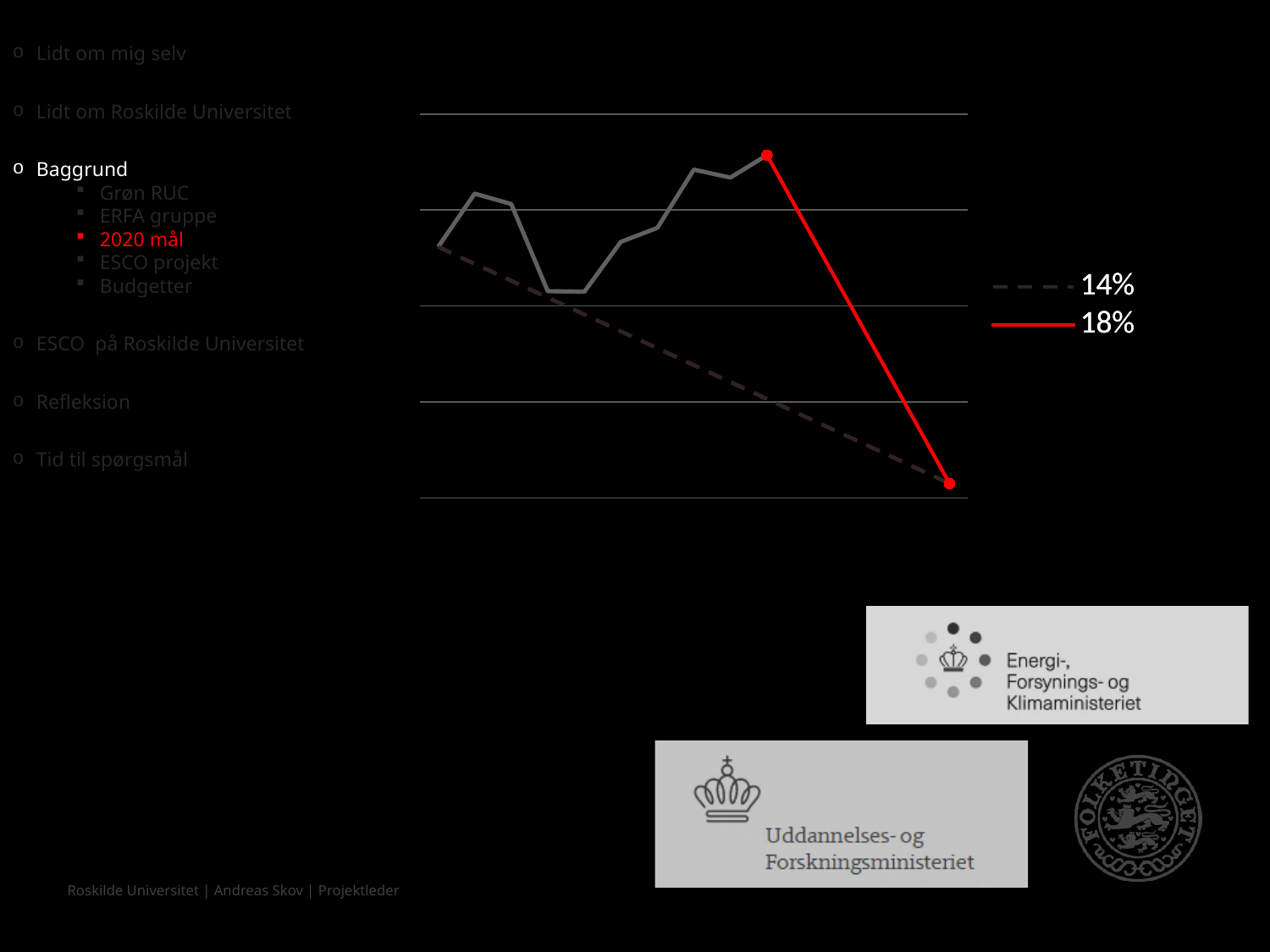
What kind of chart is shown on the slide? line chart Does the red 18% line rise or fall from left to right? fall Which legend entry is drawn as a dashed line? 14% What colour is the line for the 18% series? red How many series does the chart's legend list? 2 Does the dashed 14% line rise or fall from left to right? fall